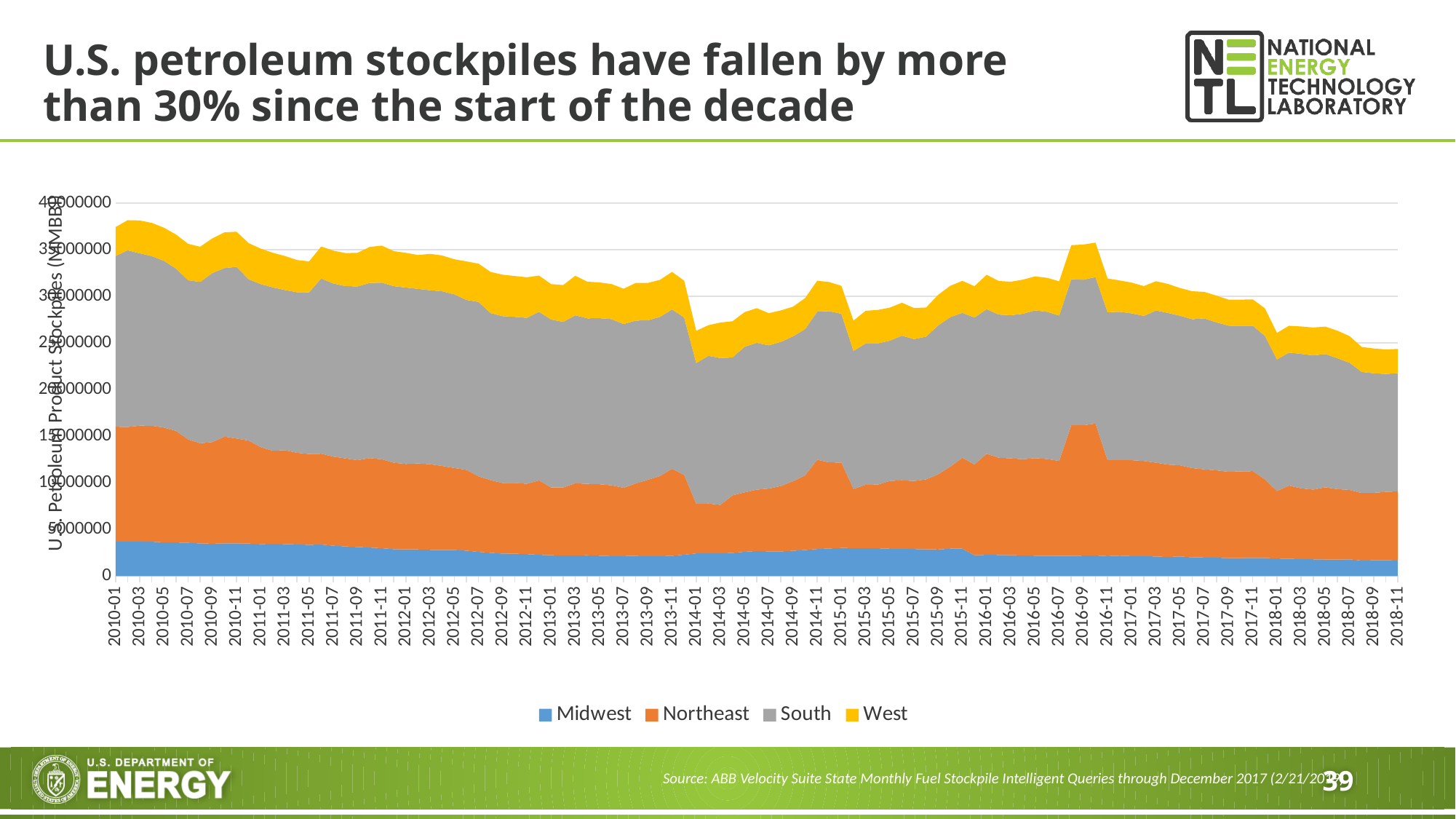
Is the total stockpile value at 2010-01 greater or less than 35000000? greater At 2018-11, which is larger, the South value or the Midwest value? South Is the total stockpile value at 2014-01 greater or less than 30000000? less What is the label of the y axis? U.S. Petroleum Product Stockpiles (MMBBL) Is the Midwest value at 2010-01 greater or less than 5000000? less What kind of chart is shown on the slide? Stacked area chart Which series are listed in the legend? Midwest, Northeast, South, West Which region contributes the largest share of stockpiles throughout the period? South How many series does the legend list? 4 Do total U.S. petroleum product stockpiles rise or fall from 2010-01 to 2018-11? Fall